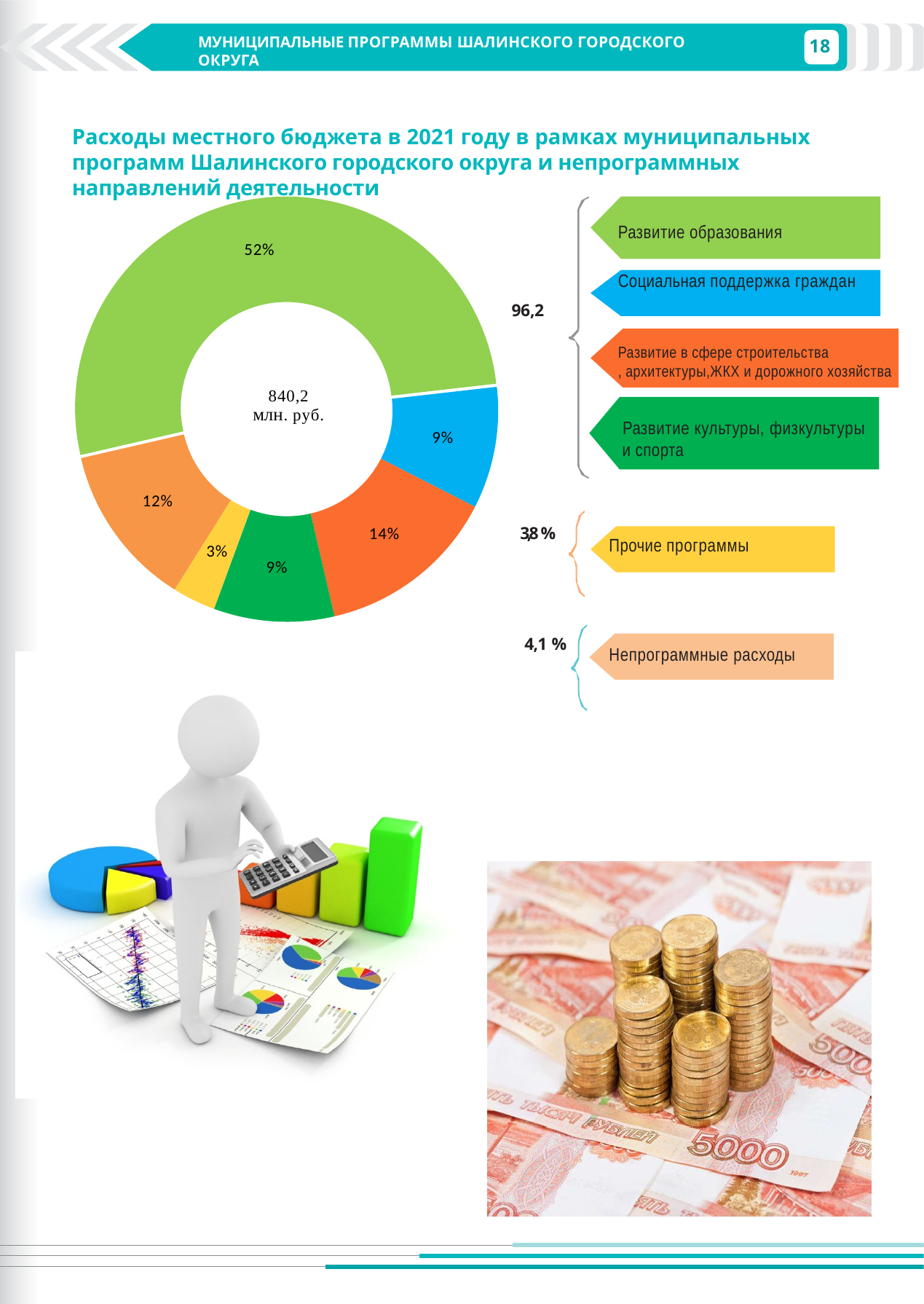
Which slice is larger: the orange 14% slice or the light orange 12% slice? The orange 14% slice What percentage is shown for the smallest slice of the donut chart? 3% What share of the donut chart does the yellow slice (Прочие программы) have? 3% What share of the donut chart does the orange slice (Развитие в сфере строительства, архитектуры, ЖКХ и дорожного хозяйства) have? 14% What share of the donut chart does the light green slice (Развитие образования) have? 52% What percentage is shown for the largest slice of the donut chart? 52% How many slices does the donut chart have? 6 What value is printed next to the bracket grouping the first four programme labels on the right? 96,2 What total value is printed in the centre of the donut chart? 840,2 млн. руб. What kind of chart is shown on the slide? Pie (donut) chart By how many percentage points does the 52% slice exceed the 14% slice? 38